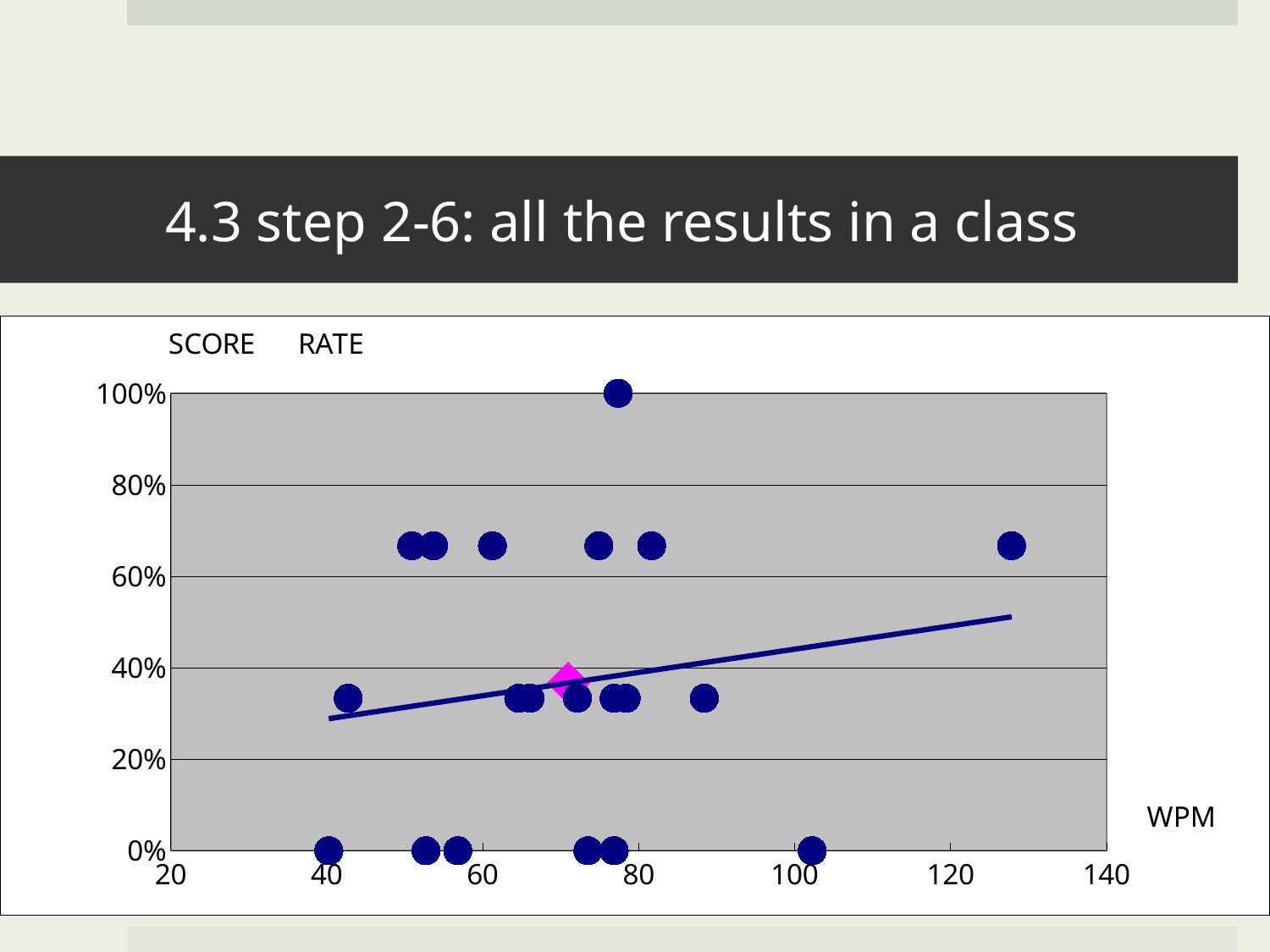
What label is shown above the y axis of the chart? SCORE RATE What kind of chart is shown on the slide? scatter chart Is the score rate of the point at about 102 WPM greater or less than 20%? less What is the highest score rate plotted on the chart? 100% What is the lowest score rate plotted on the chart? 0% Is the score rate of the point with the highest WPM (near 128 WPM) greater or less than 60%? greater Does the trend line rise or fall as WPM increases? rises What label is shown on the x axis of the chart? WPM Is the score rate of the point at about 89 WPM greater or less than 40%? less